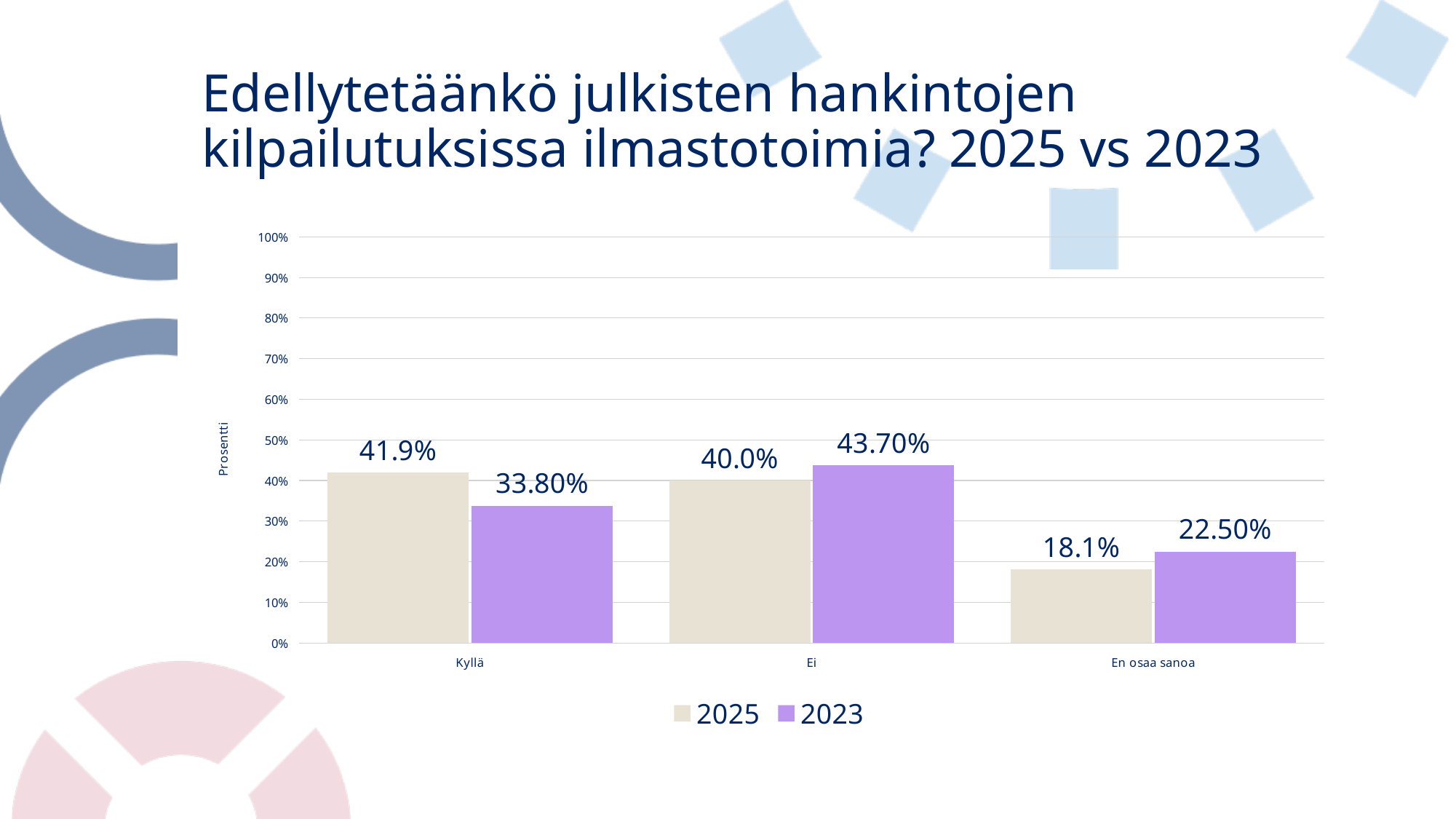
What is the label of the vertical axis? Prosentti What is the difference between the 2025 and 2023 values for Kyllä? 8.1% Which category has the lowest value in the 2025 series? En osaa sanoa Which is larger for Ei: the 2025 value or the 2023 value? 2023 What is the value for Kyllä in the 2023 series? 33.80% Which category has the highest value in the 2023 series? Ei What kind of chart is shown on the slide? Bar chart What is the value for Ei in the 2023 series? 43.70% How many series does the legend list? 2 What is the value for Kyllä in the 2025 series? 41.9% What is the value for En osaa sanoa in the 2025 series? 18.1% How many categories are shown on the x axis? 3